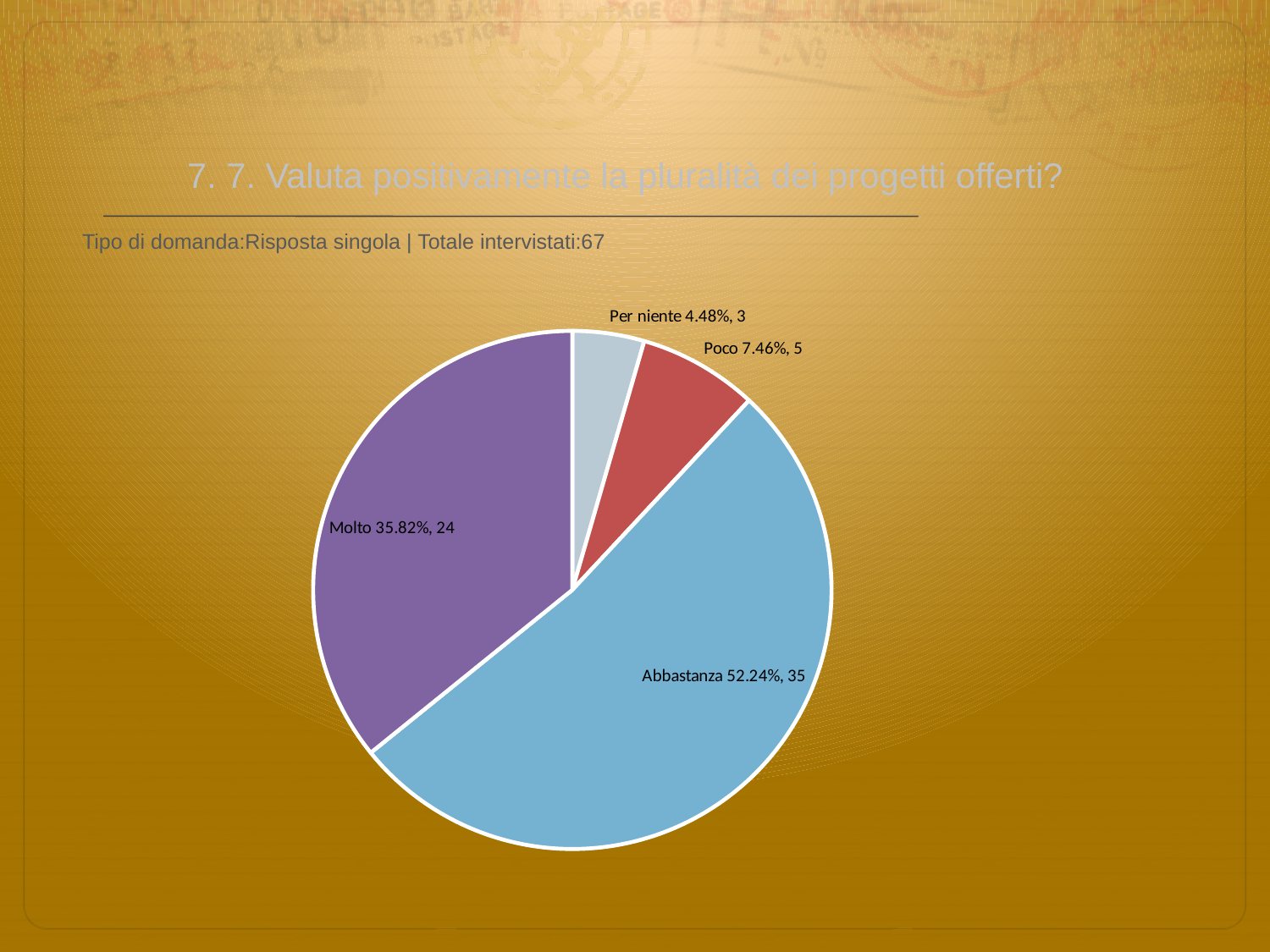
Which category has the smallest slice? Per niente How many respondents answered Molto? 24 Which category has the largest slice? Abbastanza What kind of chart is shown on the slide? pie chart How many respondents answered Poco? 5 What percentage share does the Abbastanza slice have? 52.24% How many slices does the pie chart have? 4 What colour is the Molto slice? purple What percentage share does the Per niente slice have? 4.48% What is the total number of respondents across all slices? 67 Which has more respondents, Poco or Per niente? Poco What is the difference in respondent count between Abbastanza and Molto? 11